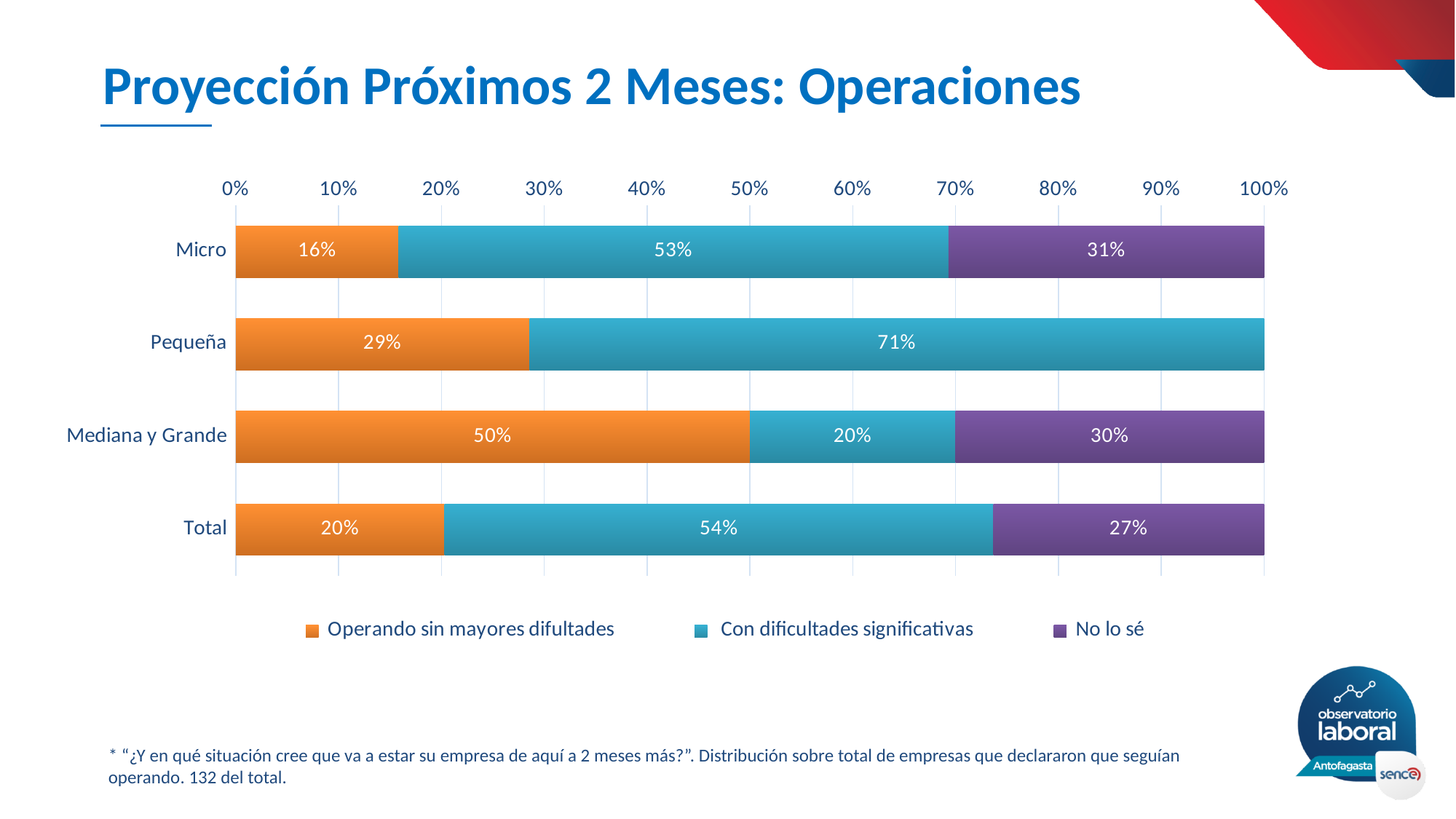
What is the 'Con dificultades significativas' value for Total? 54% What kind of chart is shown on the slide? Stacked bar chart What is the value for Pequeña in the 'Operando sin mayores difultades' series? 29% What is the difference between the 'Con dificultades significativas' values for Pequeña and Micro? 18% What is the 'No lo sé' value for Mediana y Grande? 30% Which series is shown in purple in the legend? No lo sé Which is larger: the 'No lo sé' value for Micro or for Total? Micro Which category has the lowest value for 'Con dificultades significativas'? Mediana y Grande Which category has the highest value for 'Operando sin mayores difultades'? Mediana y Grande How many categories are shown on the vertical axis? 4 How many series does the legend list? 3 What percentage of Micro companies expect to be operating with significant difficulties (Con dificultades significativas)? 53%